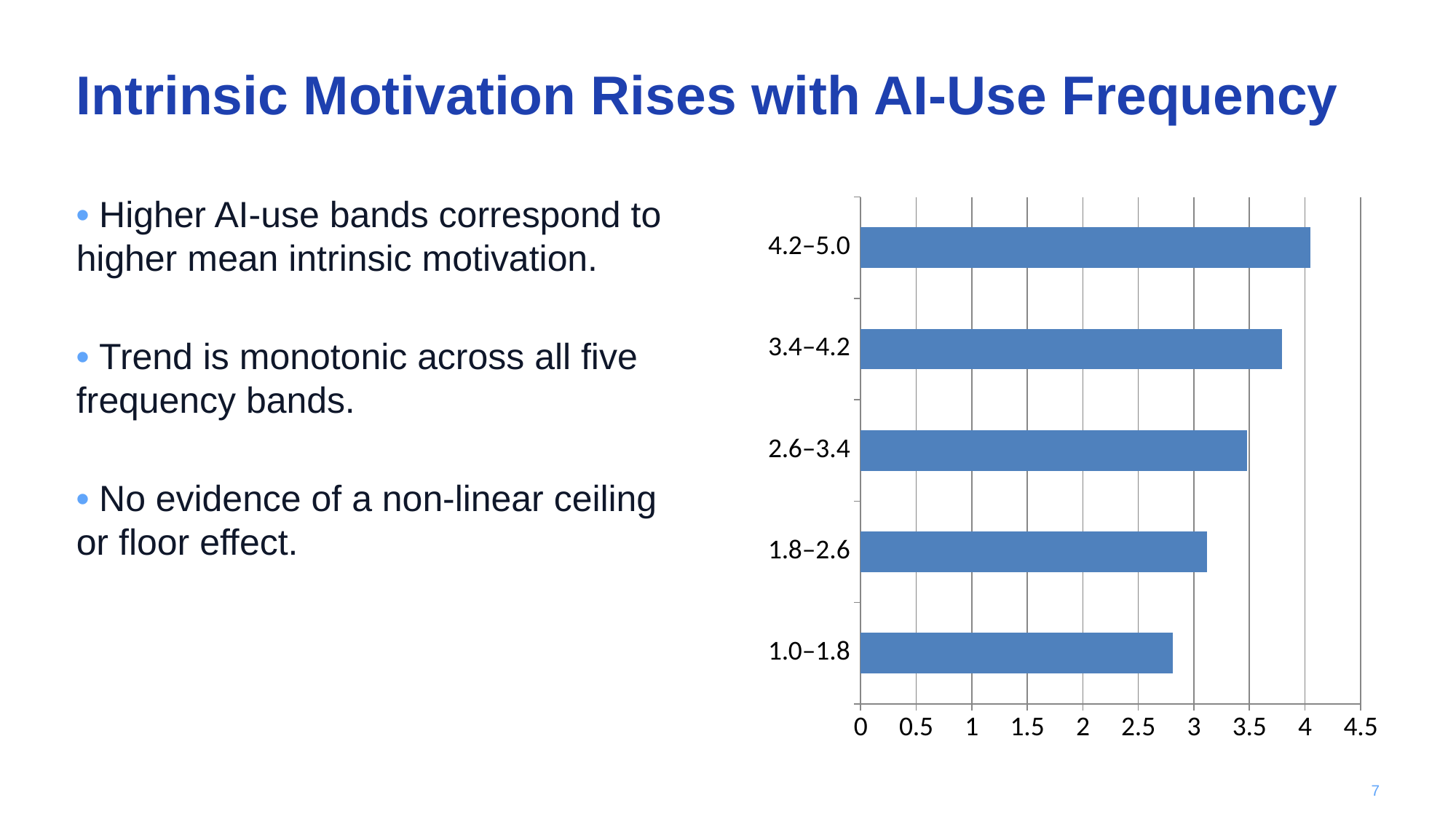
Is the value for the 3.4–4.2 band greater or less than 3.5? greater Which has the larger value, the 4.2–5.0 band or the 1.0–1.8 band? 4.2–5.0 How many AI-use frequency bands are plotted in the chart? 5 Is the value for the 1.8–2.6 band greater or less than 2.5? greater Do the bar values increase or decrease as the AI-use frequency band gets higher? increase Which has the larger value, the 3.4–4.2 band or the 1.8–2.6 band? 3.4–4.2 What is the highest tick value shown on the horizontal axis of the chart? 4.5 Which frequency band has the longest bar in the chart? 4.2–5.0 Is the value for the 1.0–1.8 band greater or less than 3? less What kind of chart is shown on the slide? bar chart Which frequency band has the shortest bar in the chart? 1.0–1.8